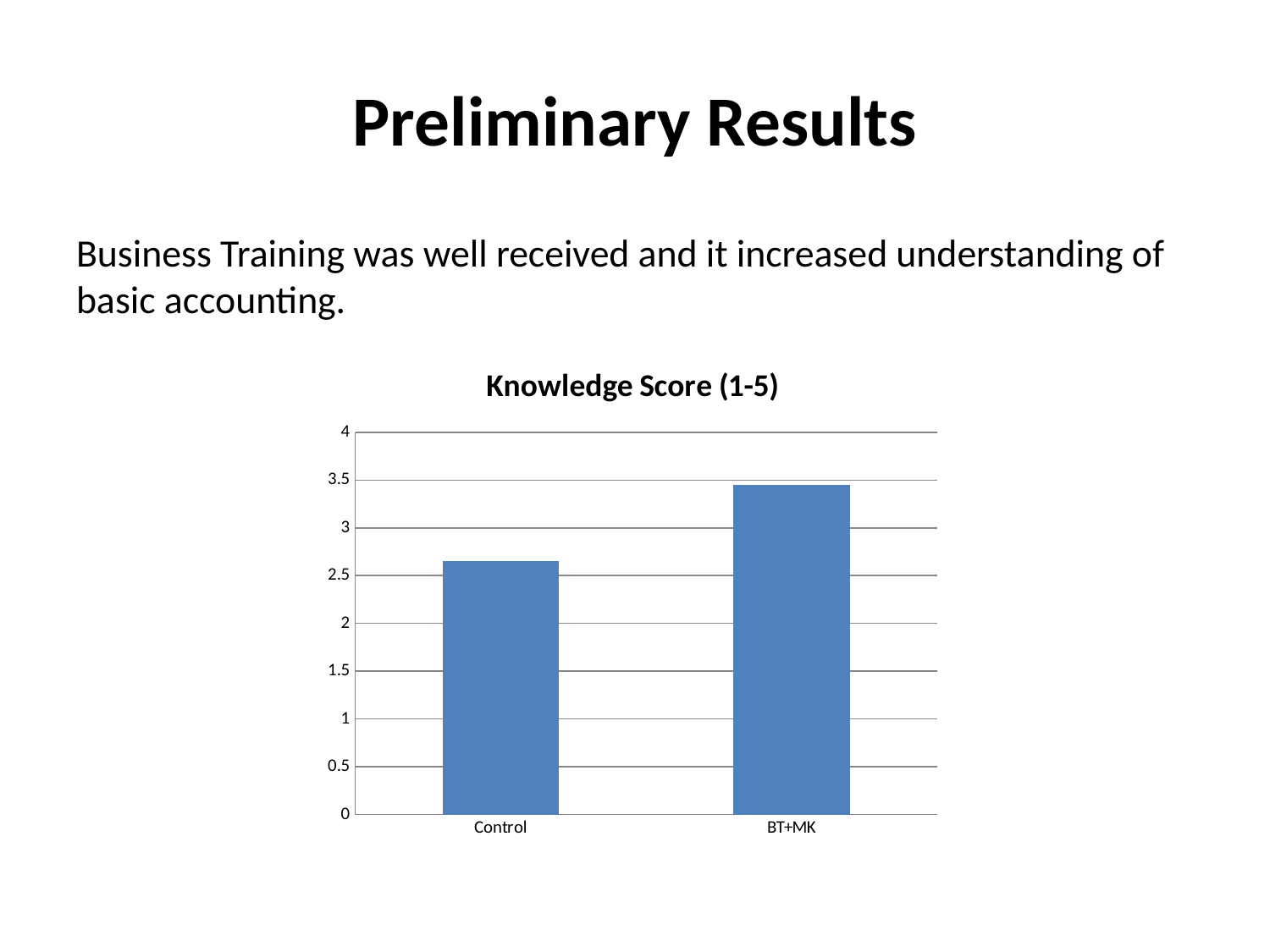
Which category has the lowest knowledge score? Control What is the title of the chart? Knowledge Score (1-5) Which is larger, the knowledge score for Control or for BT+MK? BT+MK What is the highest value shown on the y axis of the chart? 4 Which category has the highest knowledge score? BT+MK Is the value for BT+MK greater or less than 3? greater Is the value for BT+MK greater or less than 2.5? greater Is the value for Control greater or less than 3? less What type of chart is shown on the slide? bar chart How many categories are shown on the x axis of the chart? 2 Do the values rise or fall from Control to BT+MK along the x axis? rise